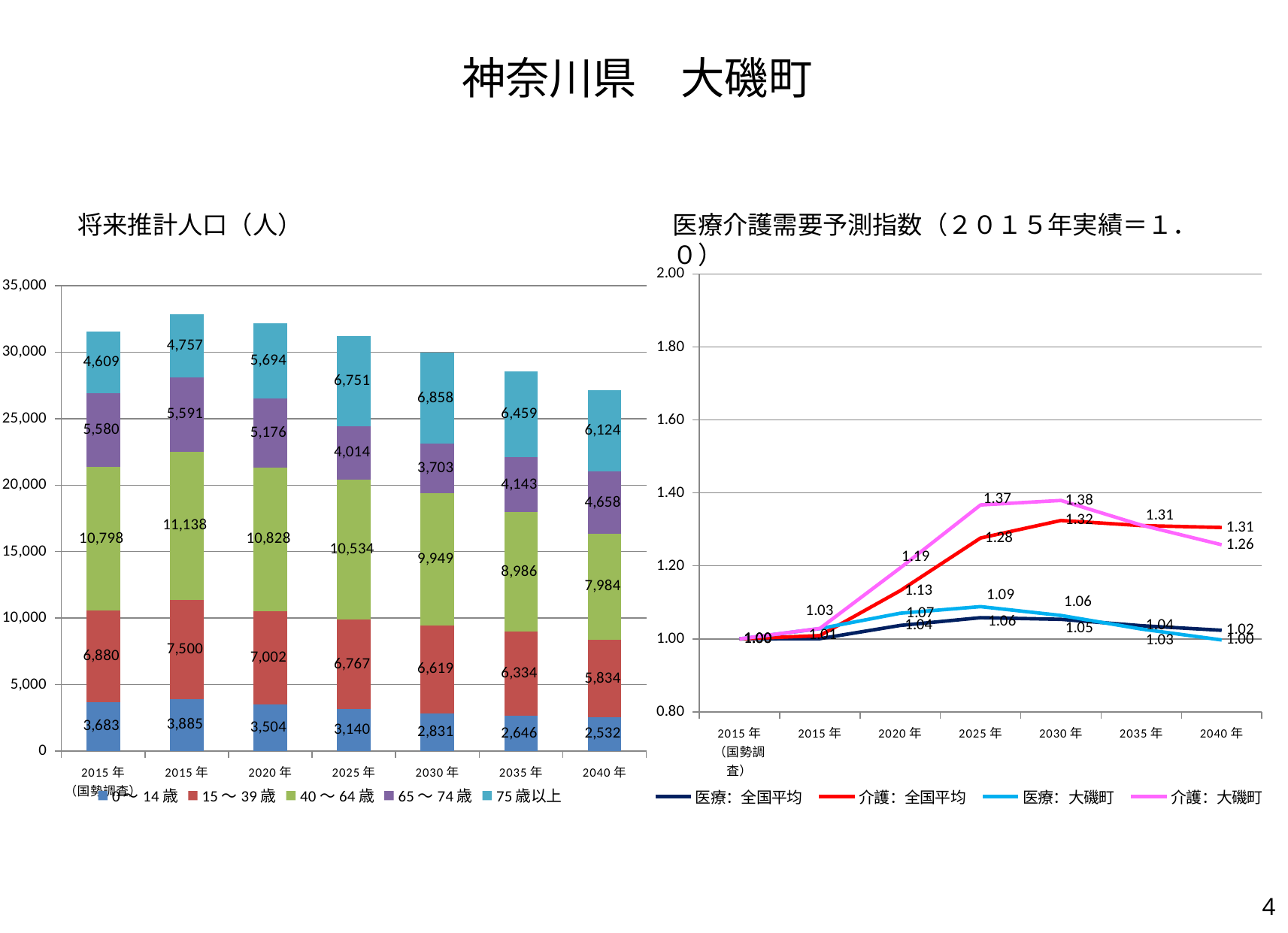
On the left chart (将来推計人口), what is the total of the stacked bar for 2040年? 27,132 On the right chart (医療介護需要予測指数), what is the value for 介護：大磯町 in 2030年? 1.38 On the right chart (医療介護需要予測指数), what is the value for 医療：大磯町 in 2025年? 1.09 On the right chart (医療介護需要予測指数), does the 介護：大磯町 line rise or fall from 2030年 to 2040年? Fall On the right chart (医療介護需要予測指数), how many series does the legend list? 4 On the left chart (将来推計人口), which year has the lowest value for 15～39歳? 2040年 On the left chart (将来推計人口), what is the value for 40～64歳 in 2015年? 11,138 On the left chart (将来推計人口), what is the difference between the 0～14歳 values for 2015年 and 2040年? 1,353 On the left chart (将来推計人口), how many series does the legend list? 5 On the left chart (将来推計人口), what kind of chart is it? Stacked bar chart On the left chart (将来推計人口), is the value for 65～74歳 larger in 2020年 or 2030年? 2020年 On the left chart (将来推計人口), what is the value for 75歳以上 in 2040年? 6,124